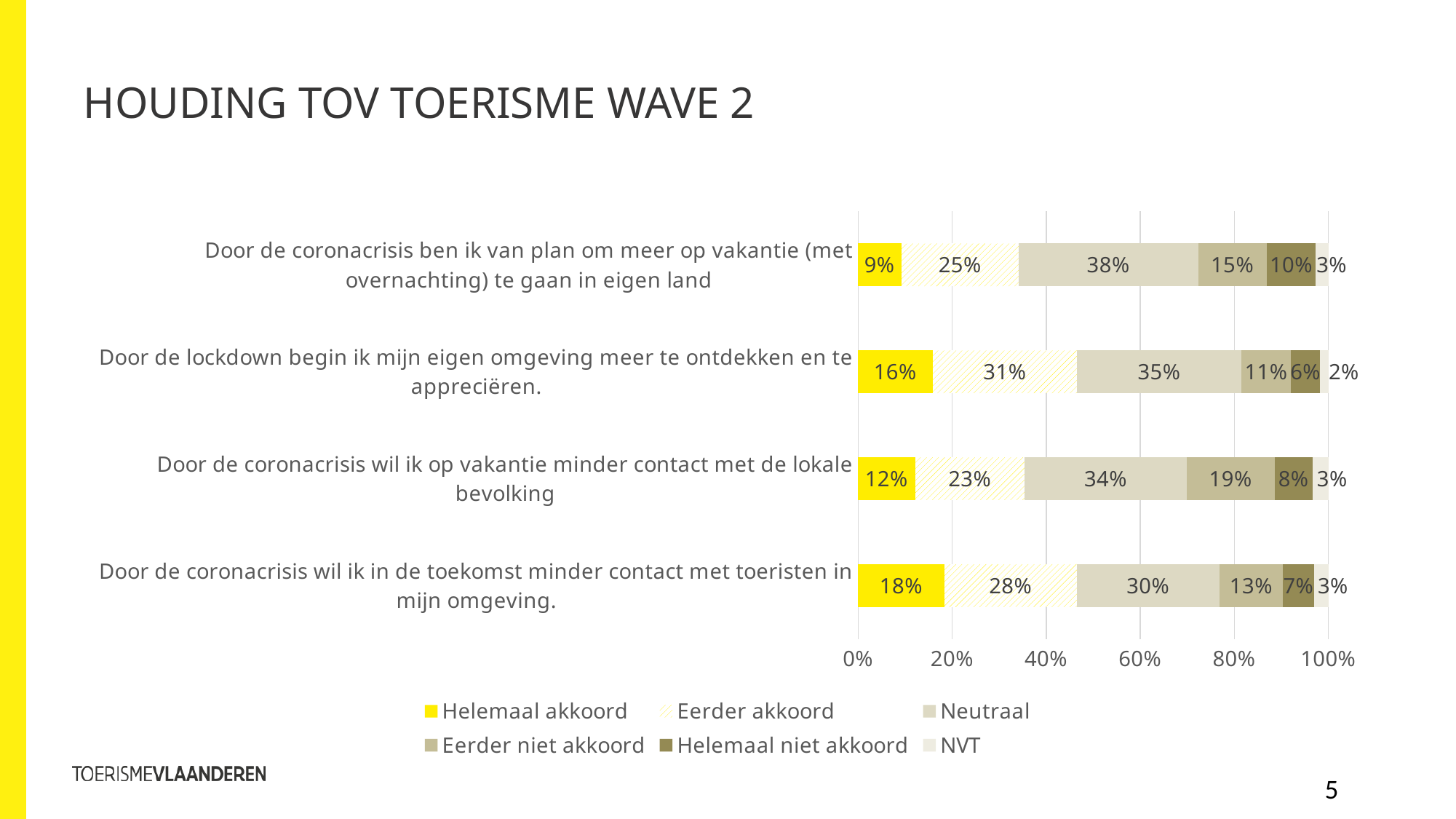
Which statement has the highest 'Helemaal akkoord' share? Door de coronacrisis wil ik in de toekomst minder contact met toeristen in mijn omgeving. What percentage answered 'Helemaal akkoord' to the statement 'Door de lockdown begin ik mijn eigen omgeving meer te ontdekken en te appreciëren.'? 16% Which statement has the lowest 'Helemaal niet akkoord' share? Door de lockdown begin ik mijn eigen omgeving meer te ontdekken en te appreciëren. What is the total of the stacked bar for 'Door de coronacrisis wil ik in de toekomst minder contact met toeristen in mijn omgeving.' (18% + 28% + 30% + 13% + 7% + 3%)? 99% How many statements (categories) are shown in the chart? 4 What is the 'Eerder niet akkoord' value for 'Door de coronacrisis wil ik op vakantie minder contact met de lokale bevolking'? 19% What is the title of the slide? HOUDING TOV TOERISME WAVE 2 How many series does the legend list? 6 What kind of chart is shown on the slide? Stacked horizontal bar chart What is the difference between the 'Eerder akkoord' values for the lockdown statement (31%) and the statement about less contact with the local population (23%)? 8 percentage points What is the 'Neutraal' value for the statement 'Door de coronacrisis ben ik van plan om meer op vakantie (met overnachting) te gaan in eigen land'? 38% Which is larger: the 'Neutraal' share for the statement about holidays in eigen land or the 'Neutraal' share for the statement about less contact with tourists? The statement about holidays in eigen land (38%)